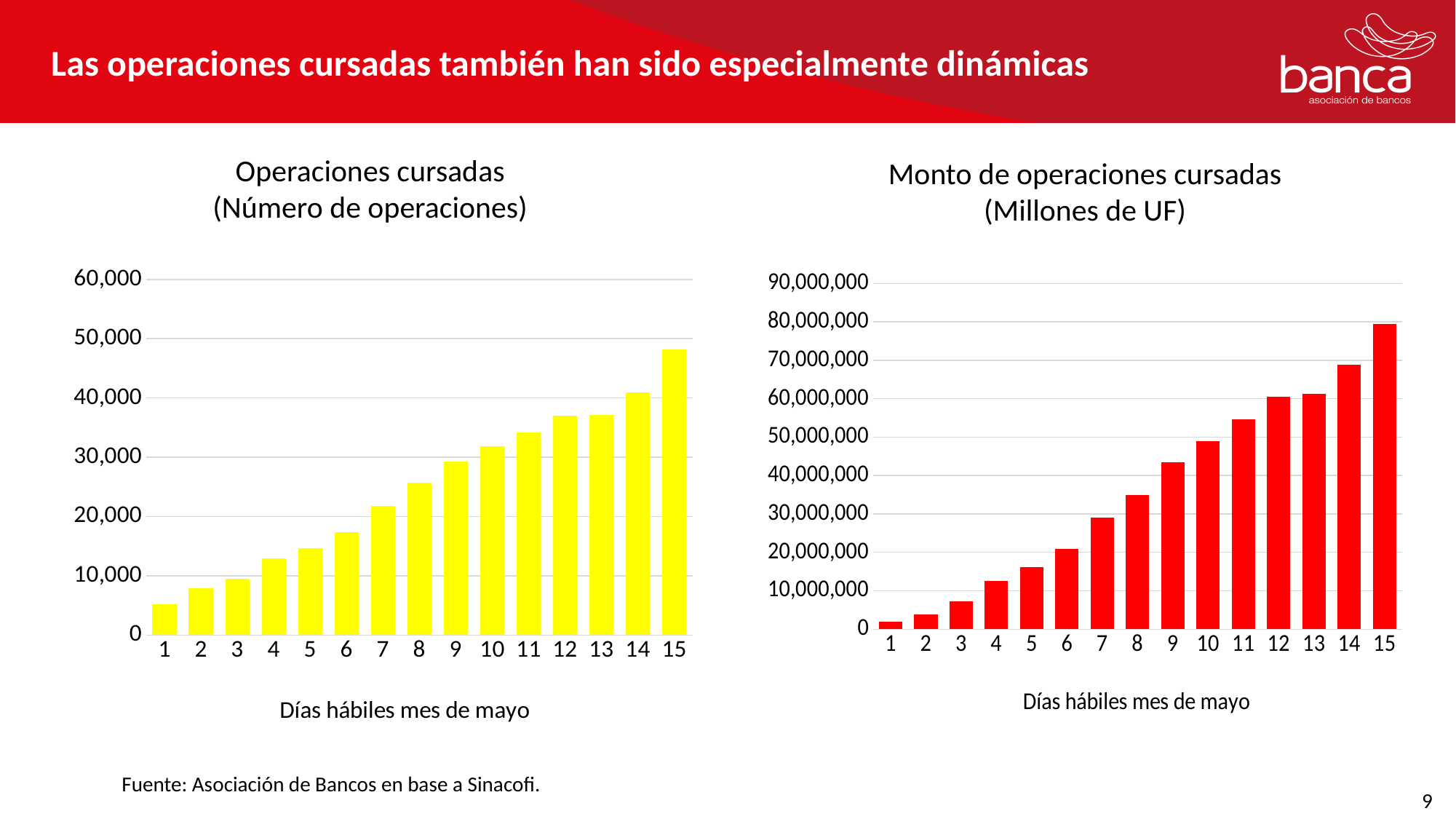
In the 'Monto de operaciones cursadas (Millones de UF)' chart, which is larger, the value for day 9 or the value for day 11? day 11 What kind of chart is the 'Monto de operaciones cursadas (Millones de UF)' chart? bar chart In the 'Operaciones cursadas (Número de operaciones)' chart, do the values rise or fall from day 1 to day 15? rise In the 'Operaciones cursadas (Número de operaciones)' chart, which day has the highest value? 15 In the 'Operaciones cursadas (Número de operaciones)' chart, is the value for day 14 greater or less than 50,000? less In the 'Monto de operaciones cursadas (Millones de UF)' chart, which day has the highest value? 15 In the 'Operaciones cursadas (Número de operaciones)' chart, which day has the lowest value? 1 How many days are plotted on the x axis of the 'Operaciones cursadas (Número de operaciones)' chart? 15 What colour are the bars in the 'Monto de operaciones cursadas (Millones de UF)' chart? red What kind of chart is the 'Operaciones cursadas (Número de operaciones)' chart? bar chart In the 'Monto de operaciones cursadas (Millones de UF)' chart, is the value for day 8 greater or less than 30,000,000? greater In the 'Operaciones cursadas (Número de operaciones)' chart, is the value for day 7 greater or less than 20,000? greater